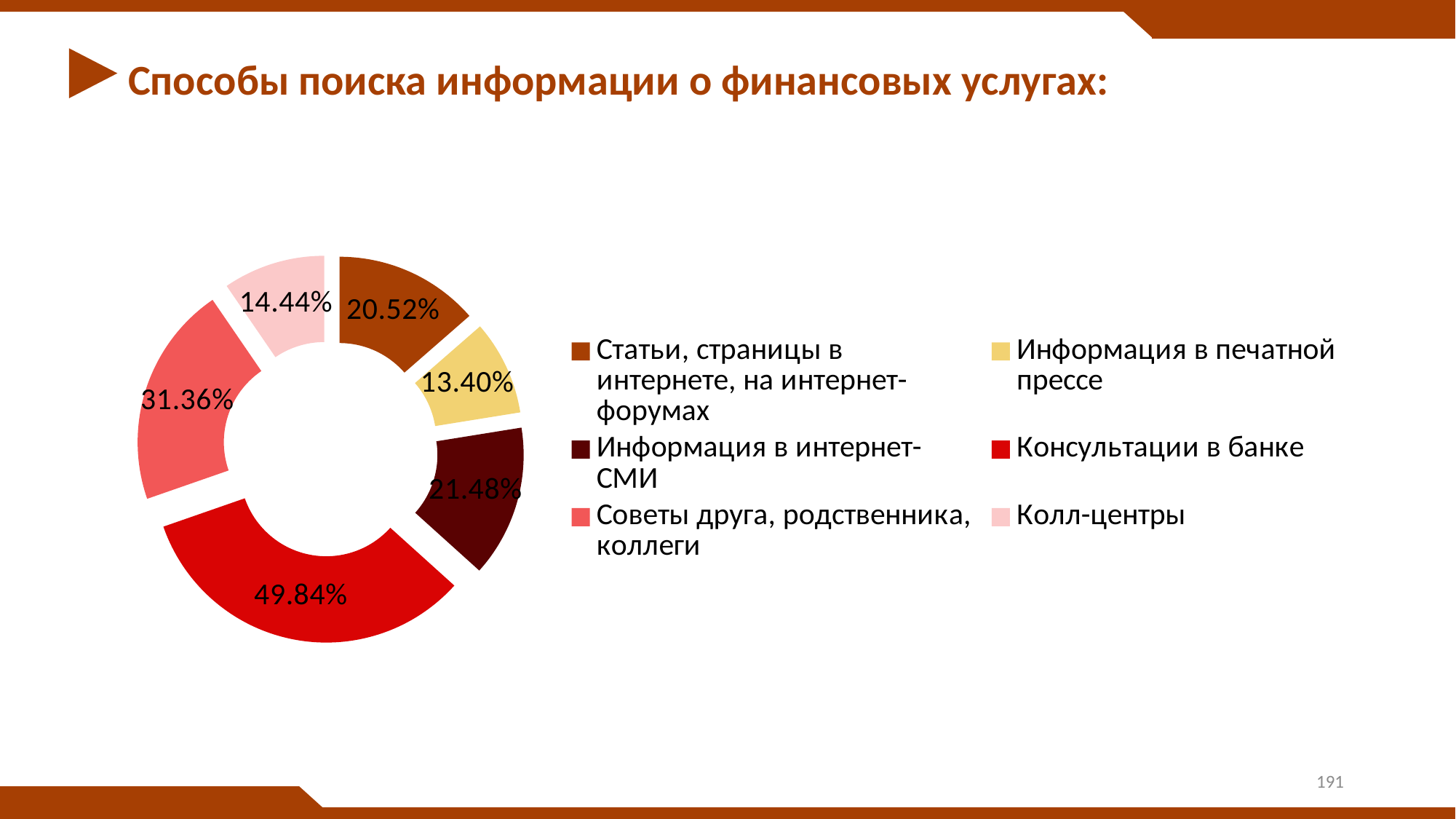
Which category has the highest value? Консультации в банке What is the value for Информация в печатной прессе? 13.40% What is the value for Колл-центры? 14.44% What is the difference between the values for Консультации в банке and Советы друга, родственника, коллеги? 18.48% What is the value for Консультации в банке? 49.84% What is the value for Информация в интернет-СМИ? 21.48% What is the title of the slide? Способы поиска информации о финансовых услугах: How many categories does the chart show? 6 What kind of chart is shown on the slide? Doughnut (pie) chart Which is larger: the value for Информация в интернет-СМИ or the value for Статьи, страницы в интернете, на интернет-форумах? Информация в интернет-СМИ What is the value for Советы друга, родственника, коллеги? 31.36% Which category has the lowest value? Информация в печатной прессе